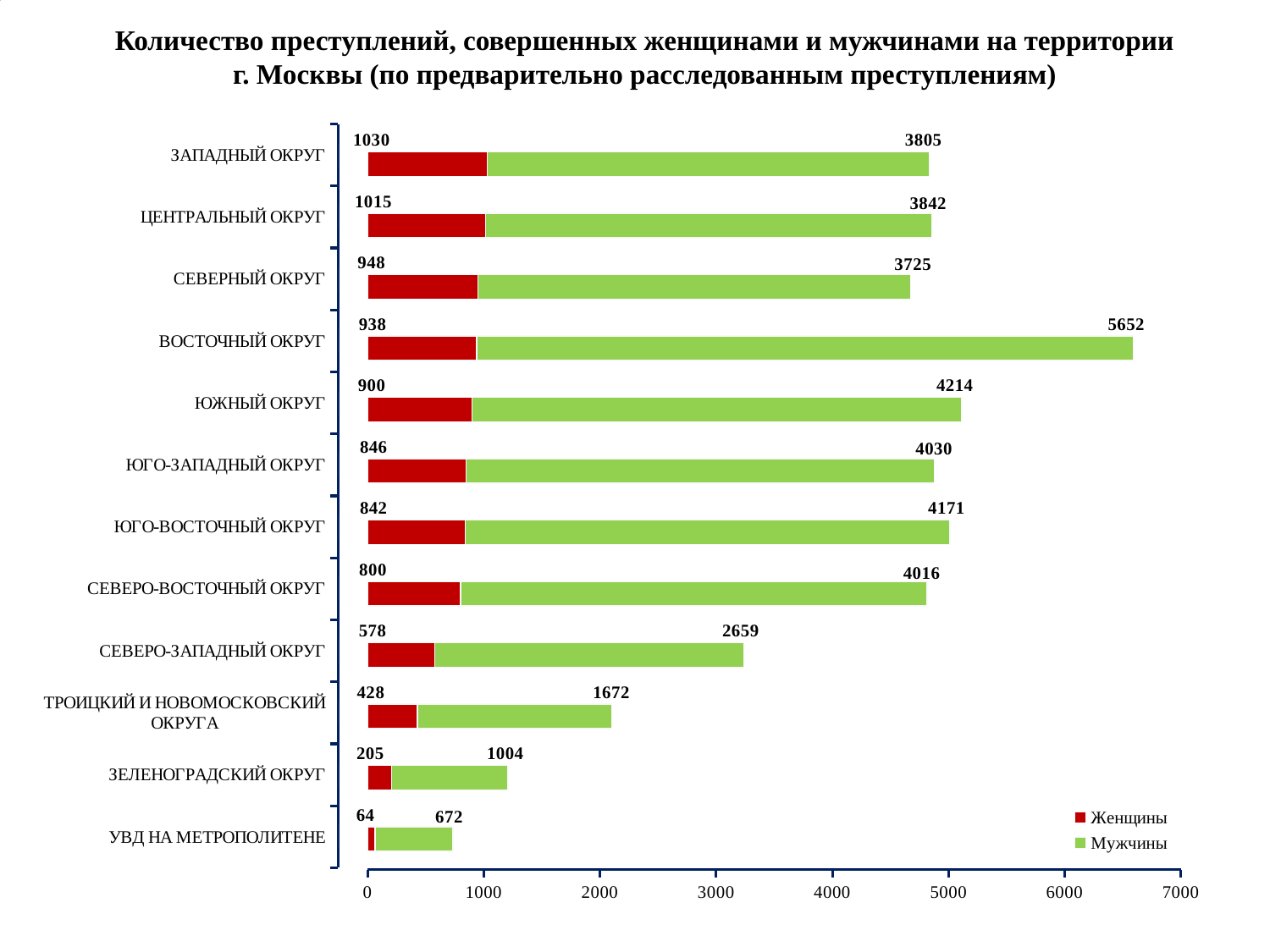
What colour represents the Женщины series in the legend? red How many districts (categories) are plotted on the chart? 12 Which has the larger Мужчины value, СЕВЕРНЫЙ ОКРУГ or ЗАПАДНЫЙ ОКРУГ? ЗАПАДНЫЙ ОКРУГ What is the total of the stacked bar for ЗЕЛЕНОГРАДСКИЙ ОКРУГ? 1209 What is the difference between the Мужчины values for ЮЖНЫЙ ОКРУГ and ЮГО-ЗАПАДНЫЙ ОКРУГ? 184 What kind of chart is shown on the slide? bar chart Is the total of the stacked bar for СЕВЕРО-ЗАПАДНЫЙ ОКРУГ greater or less than 3000? greater Which category has the lowest value for Женщины? УВД НА МЕТРОПОЛИТЕНЕ Which district has the highest value for Мужчины? ВОСТОЧНЫЙ ОКРУГ What is the value for Женщины in ЗАПАДНЫЙ ОКРУГ? 1030 What is the value for Мужчины in ВОСТОЧНЫЙ ОКРУГ? 5652 How many series does the legend list? 2